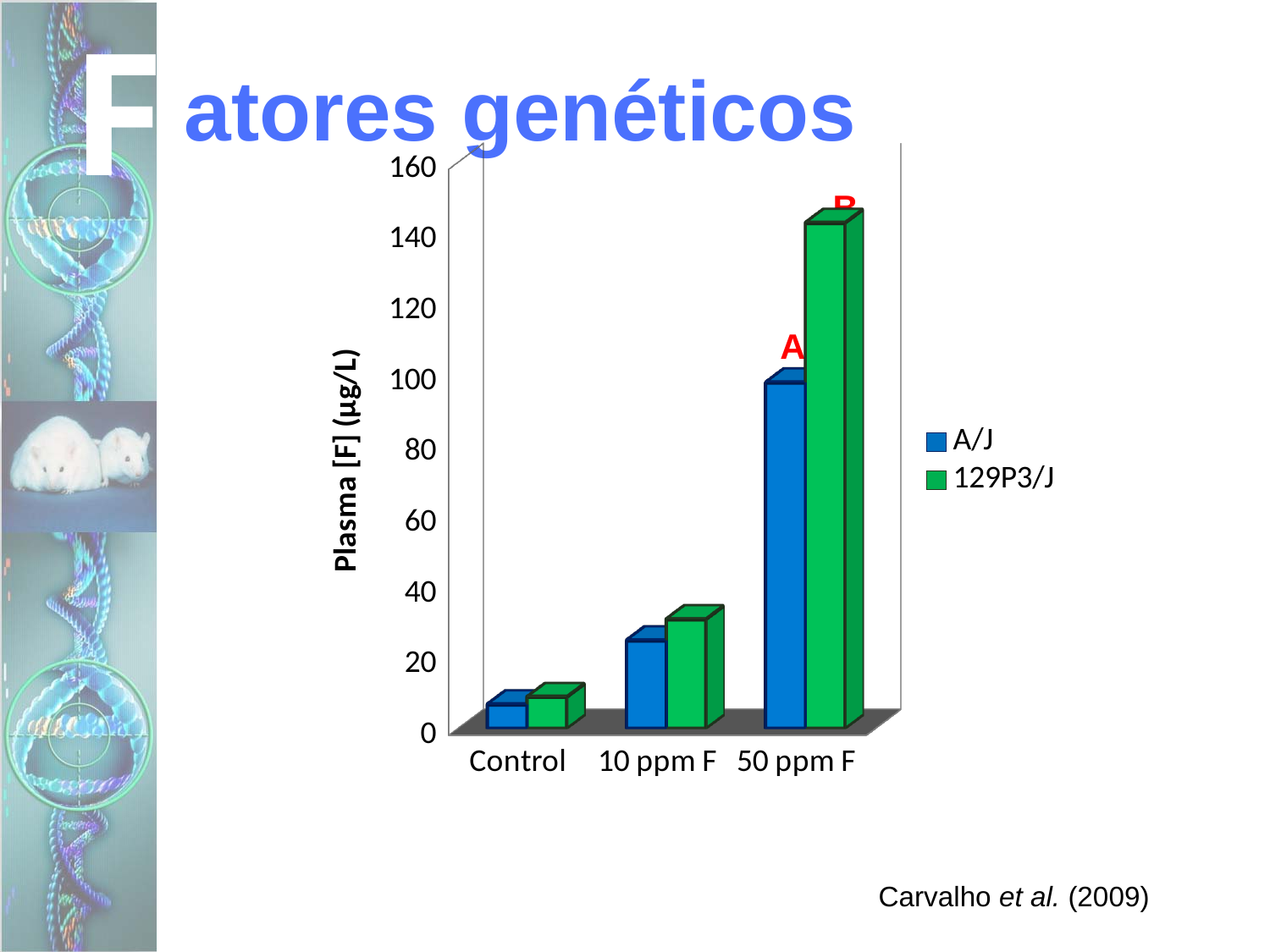
Is the value for A/J at 50 ppm F greater or less than 120? less Is the value for 129P3/J at 50 ppm F greater or less than 120? greater What is the label of the y axis? Plasma [F] (µg/L) How many series does the legend list? 2 What kind of chart is shown on the slide? bar chart Is the value for A/J at 10 ppm F greater or less than 40? less Which series is shown in green? 129P3/J How many categories are shown on the x axis? 3 At 50 ppm F, which series has the larger value, A/J or 129P3/J? 129P3/J Do the values for the 129P3/J series rise or fall from Control to 50 ppm F? rise Which category has the highest value for the 129P3/J series? 50 ppm F Which category has the lowest value for the A/J series? Control